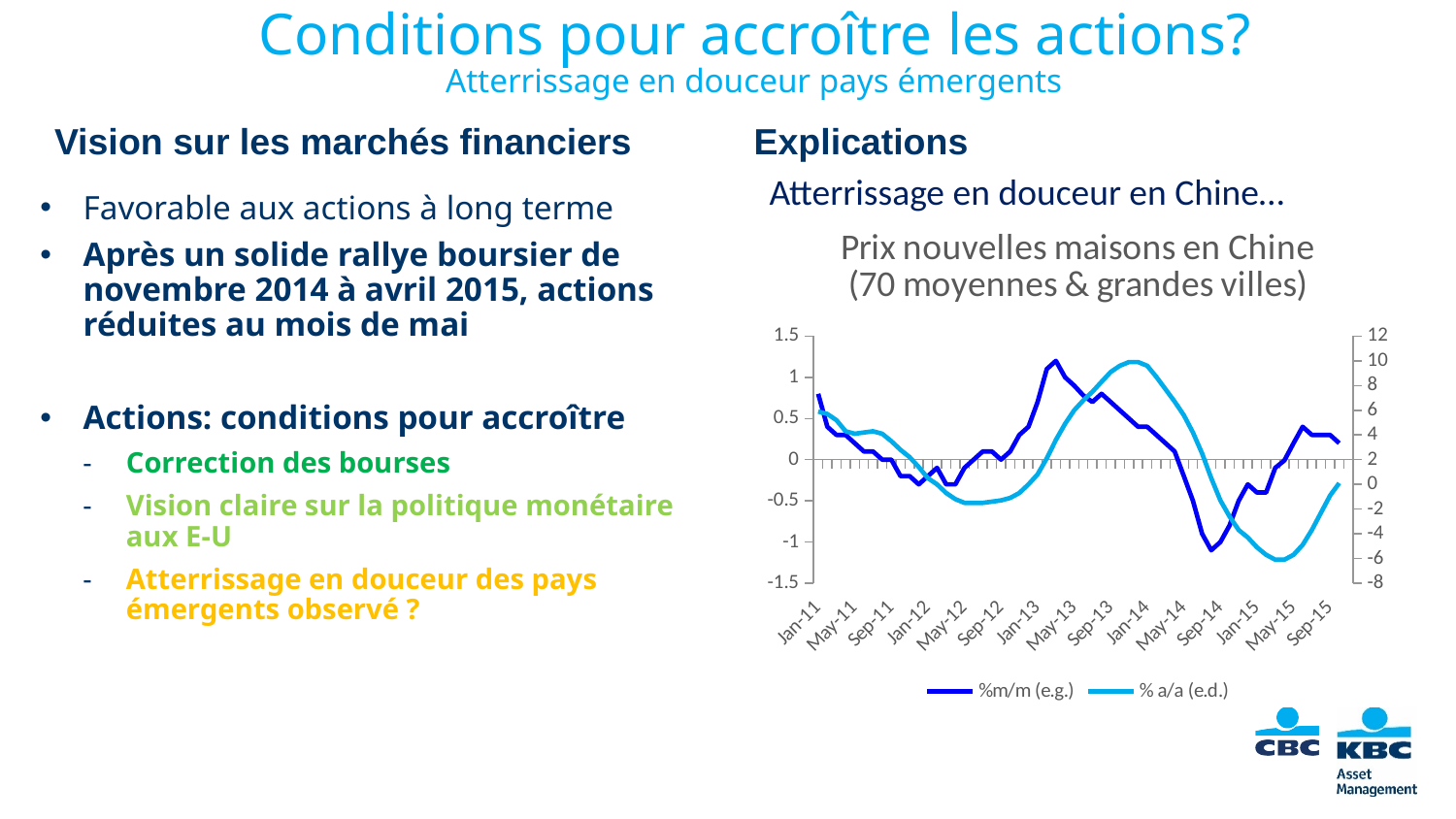
How many series does the legend of the chart list? 2 How many date labels are shown on the x axis of the chart? 15 Is the value of the %m/m (e.g.) series around Sep-14 greater or less than -0.5 on the left axis? less Around which x-axis label does the %m/m (e.g.) series reach its lowest point? Sep-14 What are the two series named in the chart legend? %m/m (e.g.) and % a/a (e.d.) Does the % a/a (e.d.) series rise or fall between Jan-14 and May-15? fall Is the value of the % a/a (e.d.) series around May-15 greater or less than -4 on the right axis? less Is the value of the % a/a (e.d.) series around Jan-14 greater or less than 8 on the right axis? greater What is the subtitle in parentheses under the chart title 'Prix nouvelles maisons en Chine'? 70 moyennes & grandes villes What kind of chart is shown under 'Prix nouvelles maisons en Chine'? line chart